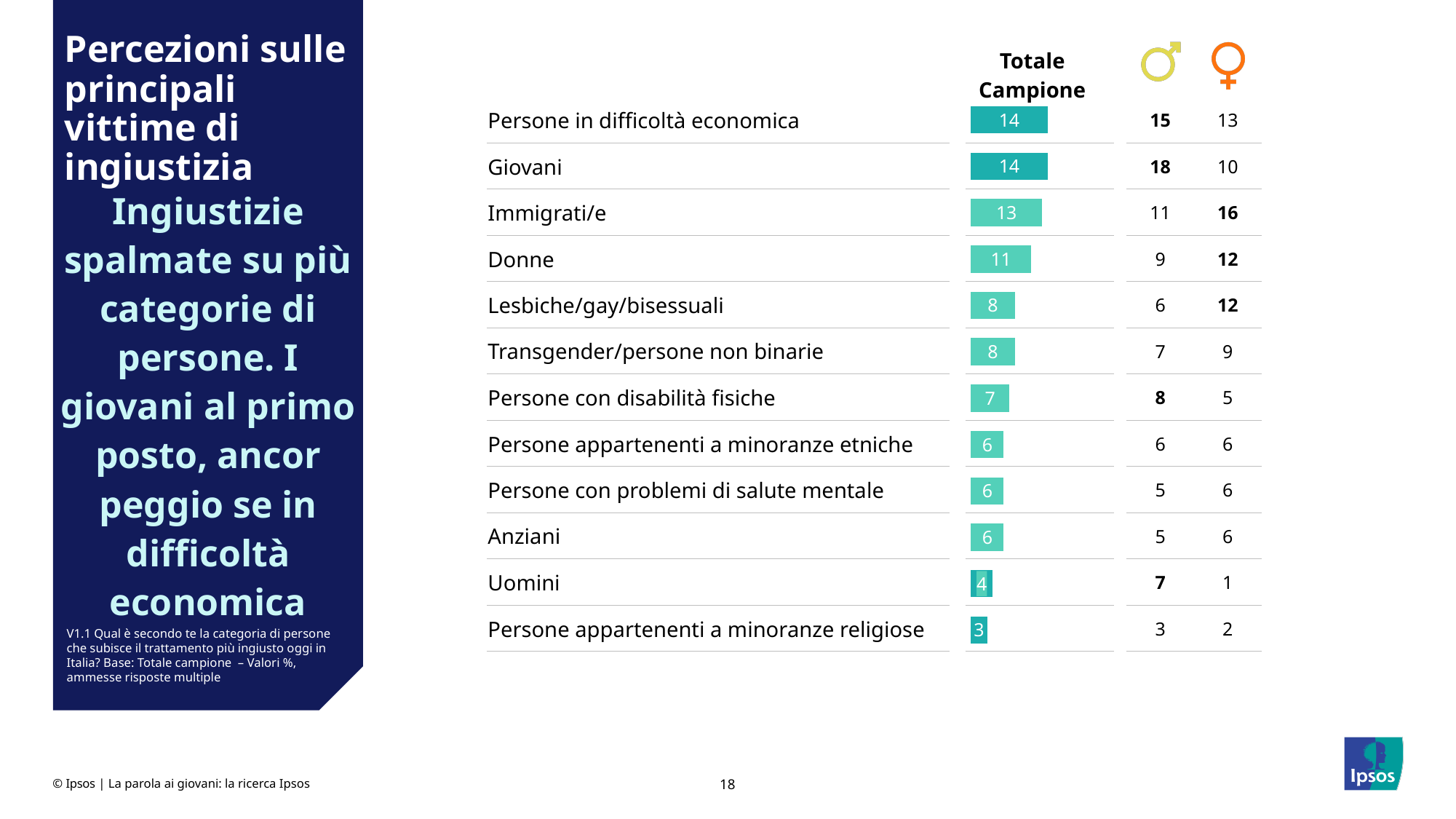
What is the value for Immigrati/e in the female column? 16 What is the Totale Campione value for Persone con disabilità fisiche? 7 What is the Totale Campione value for Donne? 11 What is the value for Giovani in the male column? 18 What is the difference between the Totale Campione values for Immigrati/e and Uomini? 9 What is the Totale Campione value for Immigrati/e? 13 Which has a higher Totale Campione value, Donne or Anziani? Donne Which category has the lowest Totale Campione value? Persone appartenenti a minoranze religiose What is the difference between the Totale Campione values for Giovani and Lesbiche/gay/bisessuali? 6 What is the Totale Campione value for Uomini? 4 What kind of chart is shown on the slide? Bar chart How many categories are shown in the chart? 12